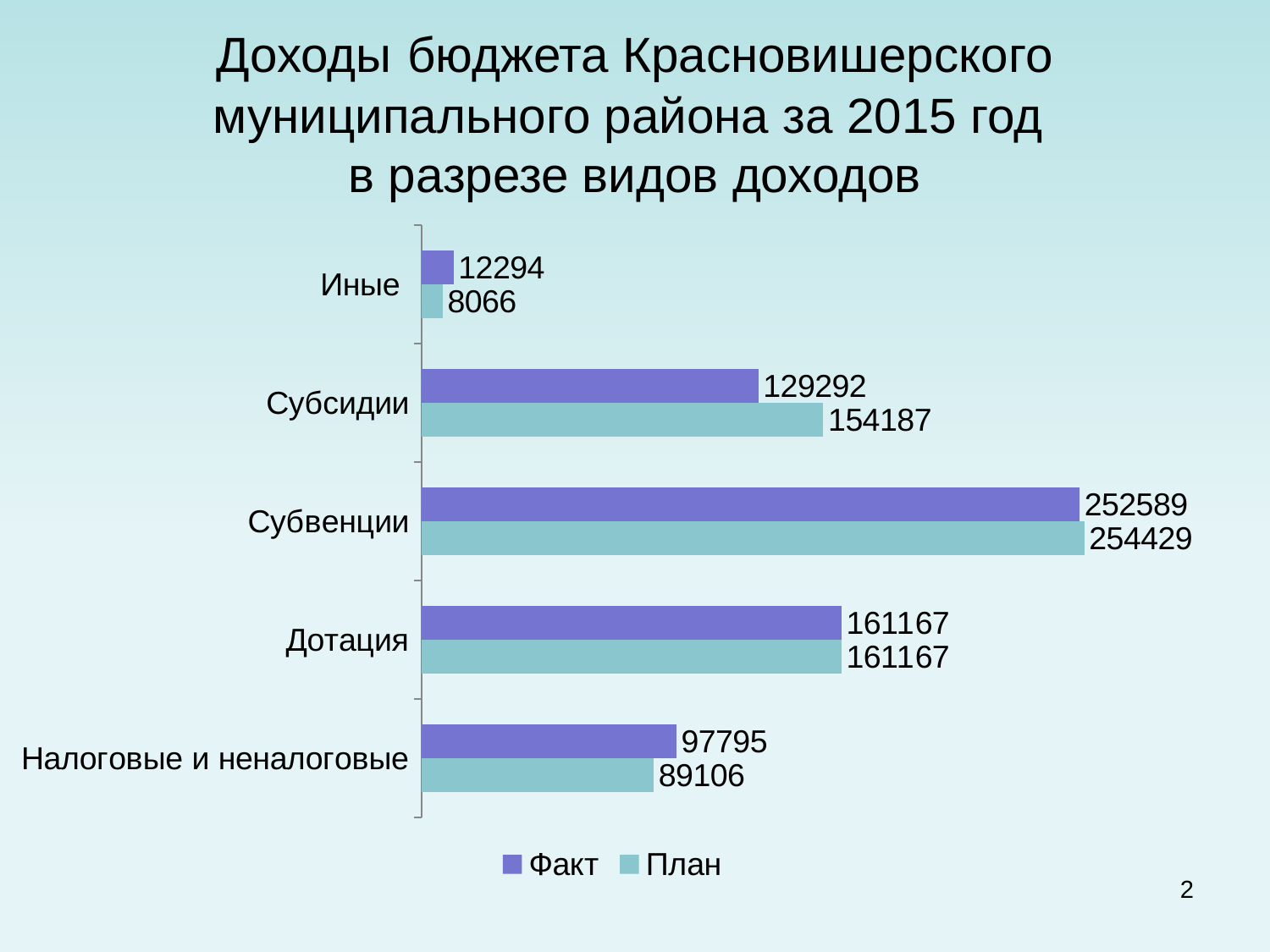
Which is larger for Налоговые и неналоговые, Факт or План? Факт What is the difference between the Факт and План values for Иные? 4228 What is the План value for Налоговые и неналоговые? 89106 How many categories are shown on the chart? 5 Which series is shown in purple? Факт What is the План value for Иные? 8066 What is the Факт value for Субсидии? 129292 What is the difference between the План and Факт values for Субсидии? 24895 Which category has the lowest План value? Иные How many series does the legend list? 2 What kind of chart is shown on the slide? bar chart Which category has the highest Факт value? Субвенции